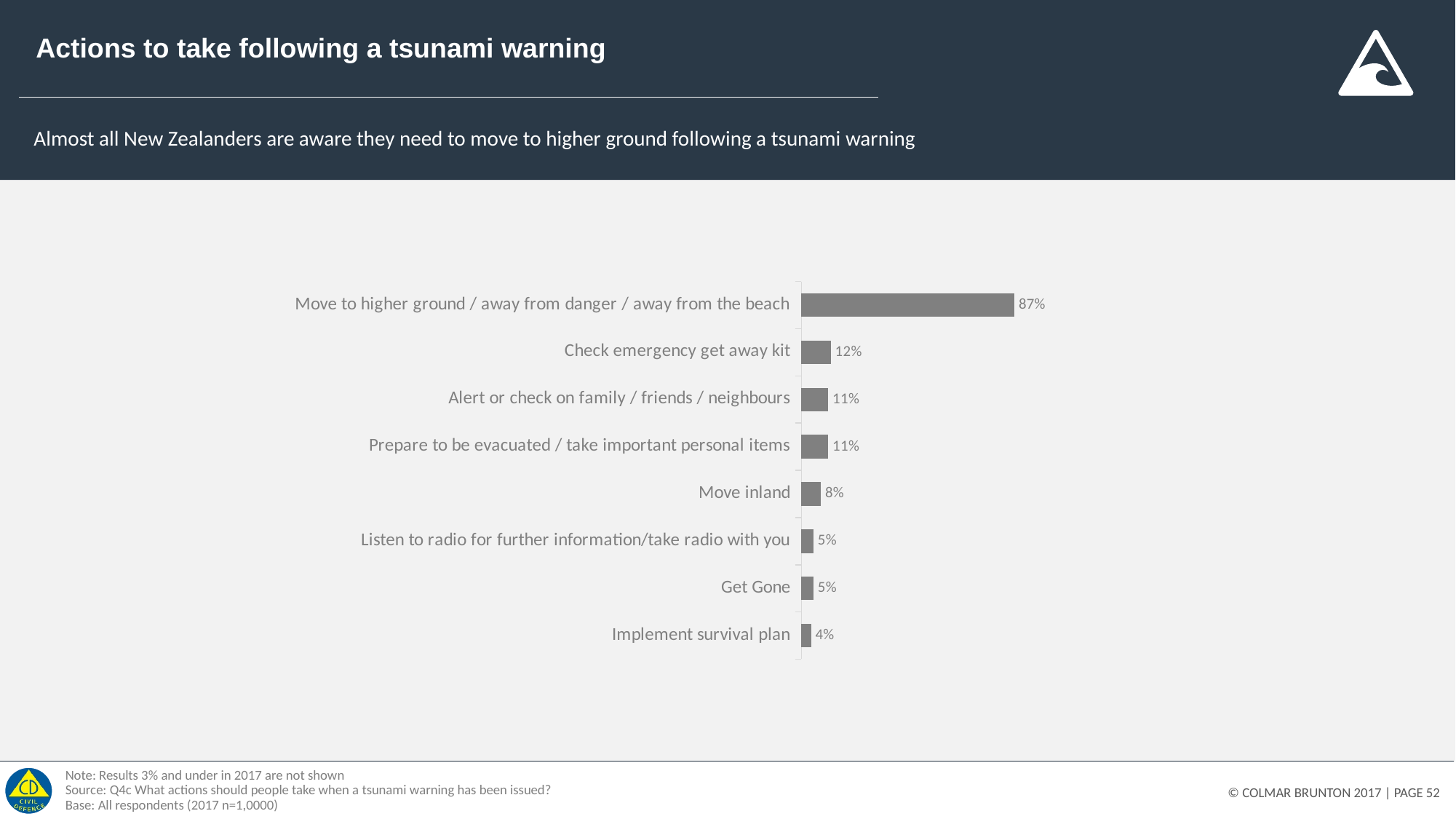
How many actions are shown in the chart? 8 Which action has the highest percentage? Move to higher ground / away from danger / away from the beach What is the title of the slide? Actions to take following a tsunami warning What is the difference between 'Move to higher ground / away from danger / away from the beach' and 'Check emergency get away kit'? 75% What is the value for 'Move inland'? 8% Which action has the lowest percentage? Implement survival plan What is the value for 'Implement survival plan'? 4% Which is larger, 'Check emergency get away kit' or 'Move inland'? Check emergency get away kit What kind of chart is shown on the slide? Bar chart What is the value for 'Check emergency get away kit'? 12% What is the difference between 'Move inland' and 'Get Gone'? 3% What percentage of respondents said to move to higher ground / away from danger / away from the beach? 87%